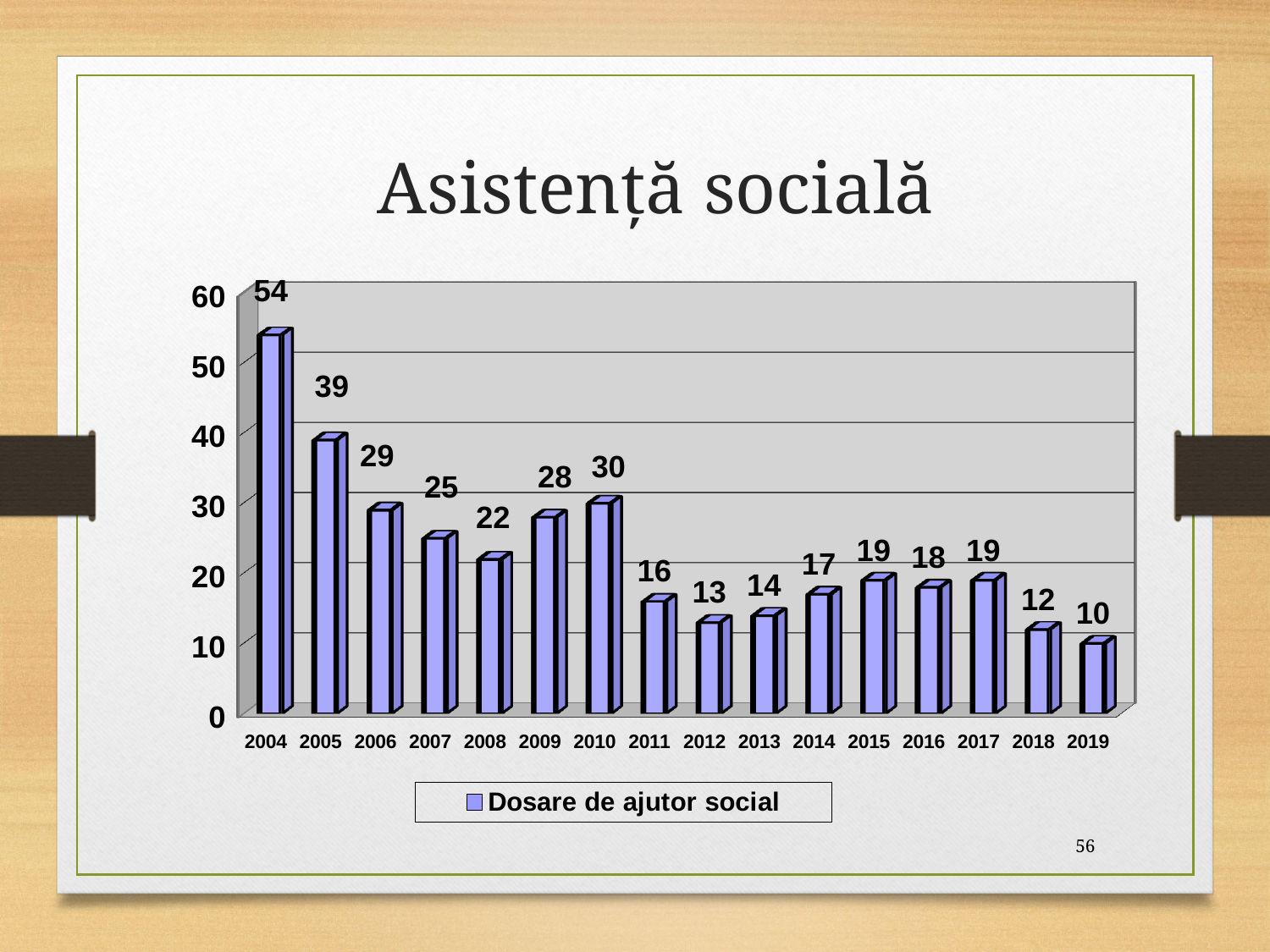
What is the value for 2018? 12 How many years are shown on the x axis? 16 What kind of chart is shown on the slide? bar chart What is the name of the series in the legend? Dosare de ajutor social What is the value for 2004? 54 Which is larger, the value for 2009 or the value for 2010? 2010 What is the difference between the values for 2004 and 2005? 15 How many series does the legend list? 1 What is the value for 2010? 30 Is the value for 2006 greater or less than 20? greater Which year has the lowest value? 2019 Which year has the highest value? 2004